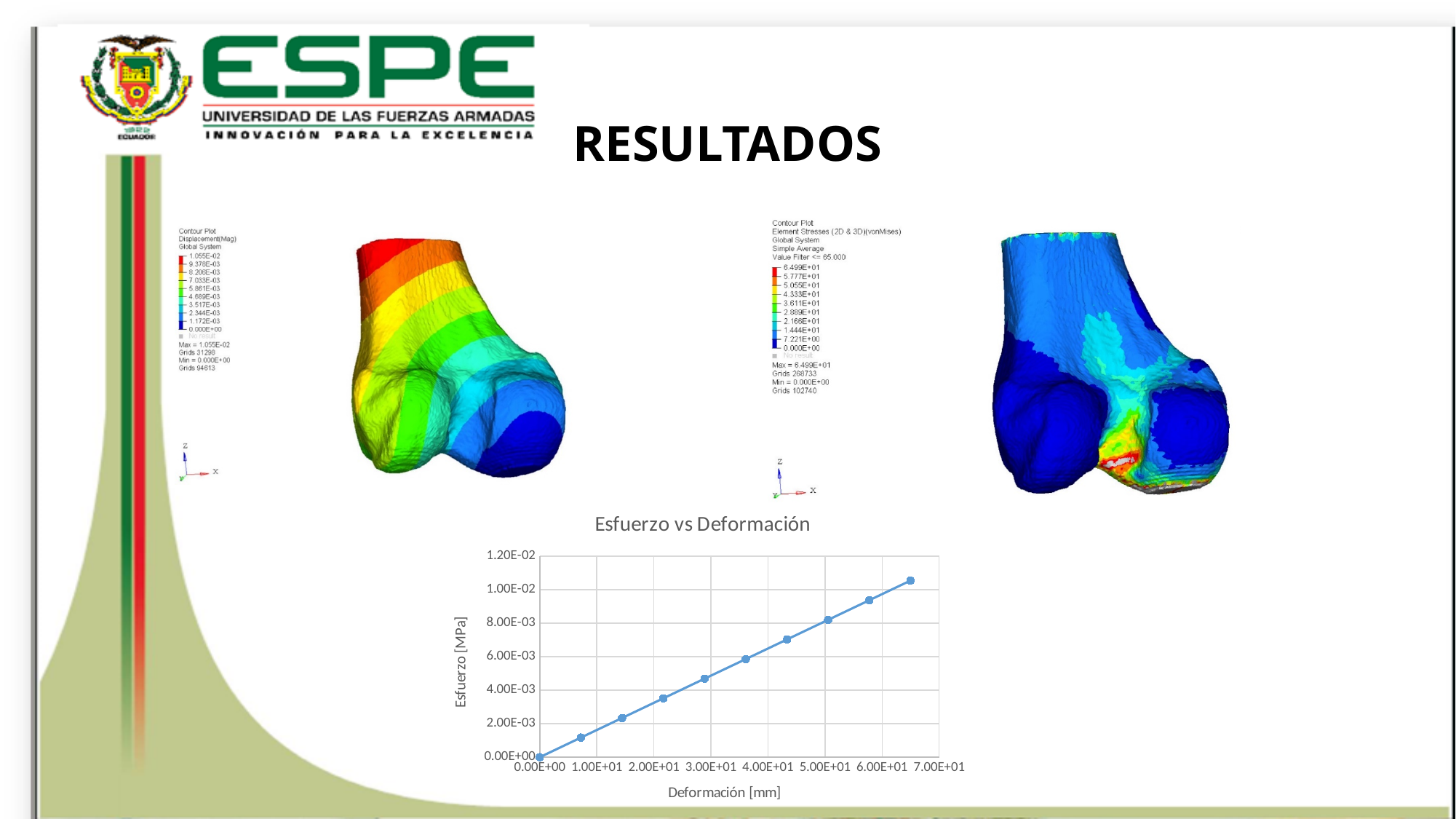
What is the label of the vertical axis in the "Esfuerzo vs Deformación" chart? Esfuerzo [MPa] In the "Esfuerzo vs Deformación" chart, what is the highest tick value shown on the vertical axis? 1.20E-02 In the "Esfuerzo vs Deformación" chart, do the values rise or fall as Deformación increases? rise In the "Esfuerzo vs Deformación" chart, is the Deformación value of the rightmost point greater or less than 6.00E+01? greater In the "Esfuerzo vs Deformación" chart, is the Esfuerzo value of the fifth point greater or less than 6.00E-03? less In the "Esfuerzo vs Deformación" chart, which point has the highest Esfuerzo value, the leftmost or the rightmost? the rightmost In the "Esfuerzo vs Deformación" chart, is the Esfuerzo value of the last (rightmost) point greater or less than 1.00E-02? greater How many data points are plotted in the "Esfuerzo vs Deformación" chart? 10 What kind of chart is shown under the title "Esfuerzo vs Deformación"? line chart What is the title of the line chart on the slide? Esfuerzo vs Deformación In the "Esfuerzo vs Deformación" chart, which point has the lowest Esfuerzo value, the leftmost or the rightmost? the leftmost